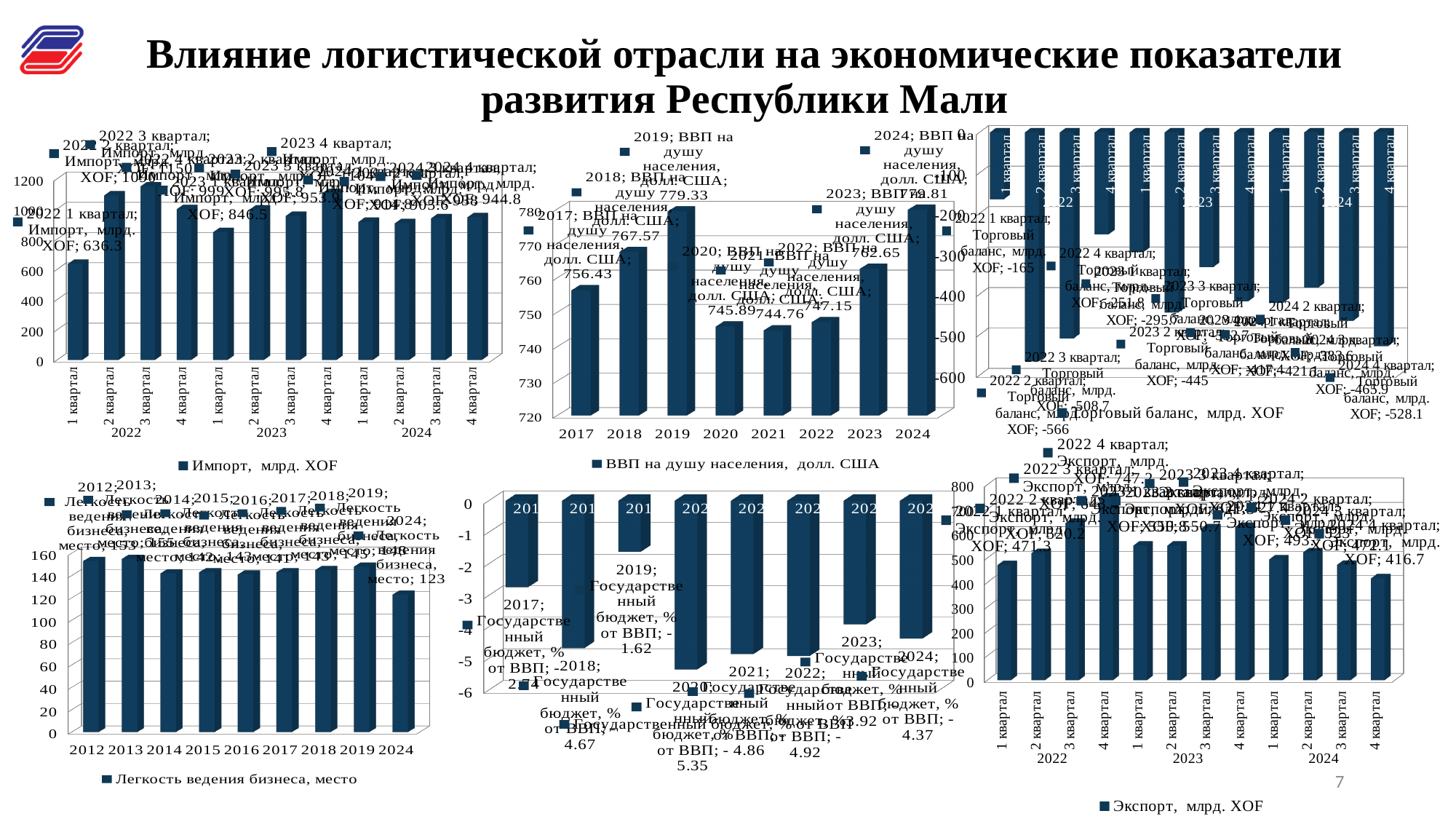
In the 'Легкость ведения бизнеса, место' chart, which year has the lowest value? 2024 In the 'Торговый баланс, млрд. XOF' chart, what is the value for 2022 2 квартал? -566 In the 'ВВП на душу населения, долл. США' chart, what is the difference between the 2018 and 2017 values? 11.14 In the 'ВВП на душу населения, долл. США' chart, what is the value for 2019? 779.33 In the 'Импорт, млрд. XOF' chart, how many bars are plotted? 12 In the 'Импорт, млрд. XOF' chart, what is the value for 2024 4 квартал? 944.8 In the 'Экспорт, млрд. XOF' chart, which quarter has the lowest value? 2024 4 квартал In the 'Импорт, млрд. XOF' chart, what is the value for 2022 1 квартал? 636.3 In the 'ВВП на душу населения, долл. США' chart, what is the value for 2021? 744.76 In the 'Торговый баланс, млрд. XOF' chart, what is the value for 2023 1 квартал? -295.7 In the 'Государственный бюджет, % от ВВП' chart, what is the value for 2020? -5.35 In the 'Легкость ведения бизнеса, место' chart, what is the value for 2019? 148